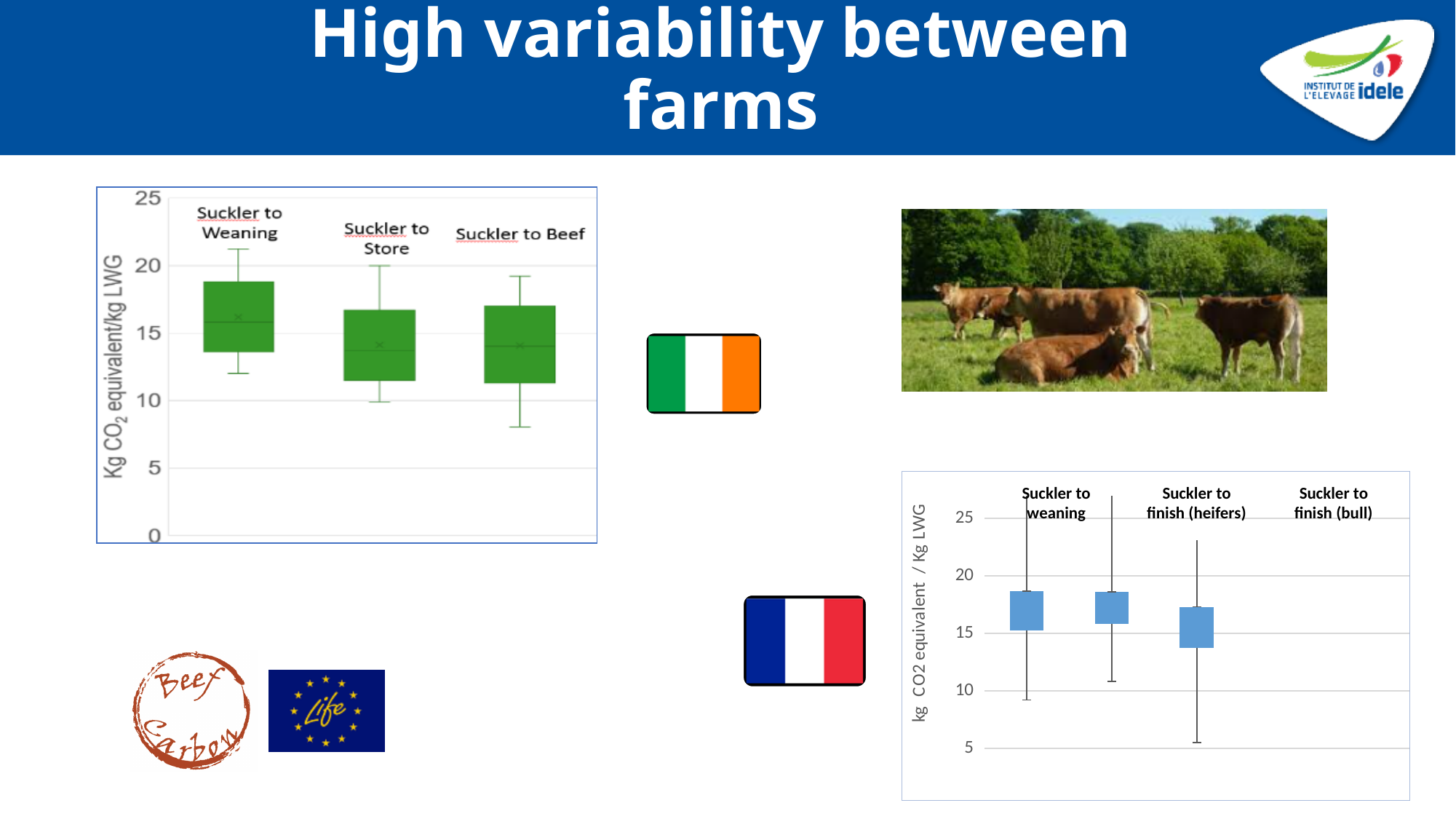
How many categories are shown on the left chart with green boxes? 3 On the right chart with blue boxes, which category has the lowest bottom whisker? Suckler to finish (bull) On the left chart with green boxes, is the top whisker for Suckler to Weaning greater or less than 20? greater On the left chart with green boxes, which category has the lower minimum whisker, Suckler to Store or Suckler to Beef? Suckler to Beef On the left chart with green boxes, is the lowest whisker for Suckler to Beef greater or less than 10? less On the left chart with green boxes, which category has the highest median line? Suckler to Weaning On the right chart with blue boxes, which category has the lowest box? Suckler to finish (bull) What kind of chart is the left chart with green boxes? box plot On the right chart with blue boxes, is the bottom whisker for Suckler to weaning greater or less than 10? less What is the y-axis label of the left chart with green boxes? Kg CO2 equivalent/kg LWG How many categories are shown on the right chart with blue boxes? 3 What is the y-axis label of the right chart with blue boxes? kg CO2 equivalent / Kg LWG